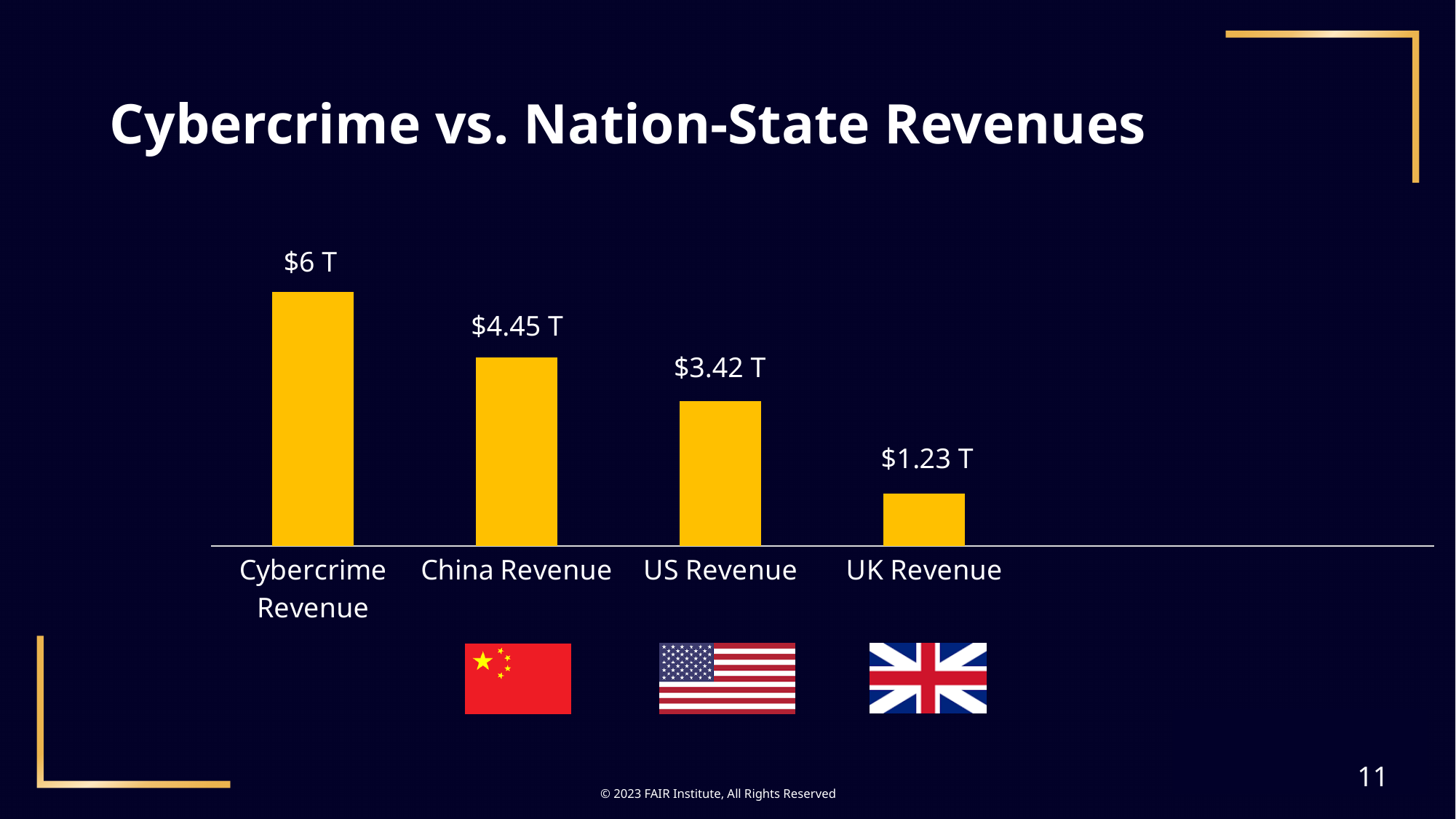
Which category has the highest value? Cybercrime Revenue What is the value for Cybercrime Revenue? $6 T What is the difference between US Revenue and UK Revenue? $2.19 T What is the value for UK Revenue? $1.23 T What is the value for China Revenue? $4.45 T Which category has the lowest value? UK Revenue What is the title of the slide? Cybercrime vs. Nation-State Revenues What kind of chart is shown on the slide? Bar chart How many categories are shown in the chart? 4 What is the difference between Cybercrime Revenue and China Revenue? $1.55 T Which is larger, China Revenue or US Revenue? China Revenue What is the value for US Revenue? $3.42 T